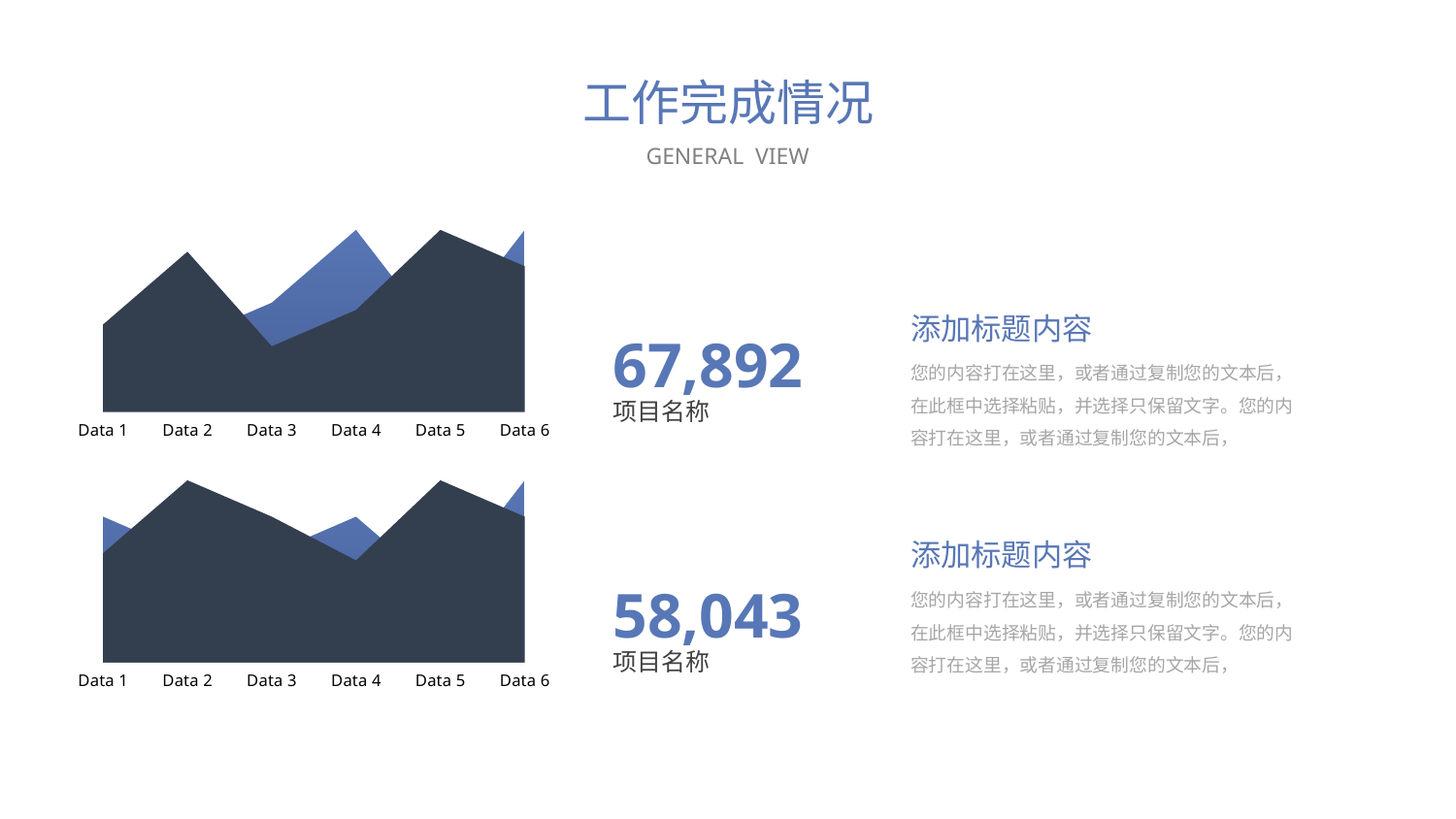
In the top chart, is the dark series higher at Data 2 or at Data 3? Data 2 In the top chart, at which category does the dark series reach its lowest point? Data 3 In the top chart, does the dark series rise or fall from Data 3 to Data 5? Rise What kind of chart is the bottom chart on the left of the slide? Area chart In the bottom chart, is the dark series higher at Data 2 or at Data 4? Data 2 How many categories are shown on the x axis of the top chart? 6 What is the label of the first category on the x axis of the bottom chart? Data 1 In the top chart, at which category does the dark series reach its highest point? Data 5 What kind of chart is the top chart on the left of the slide? Area chart How many charts are shown on the slide? 2 In the bottom chart, at which category does the dark series reach its lowest point? Data 4 How many categories are shown on the x axis of the bottom chart? 6